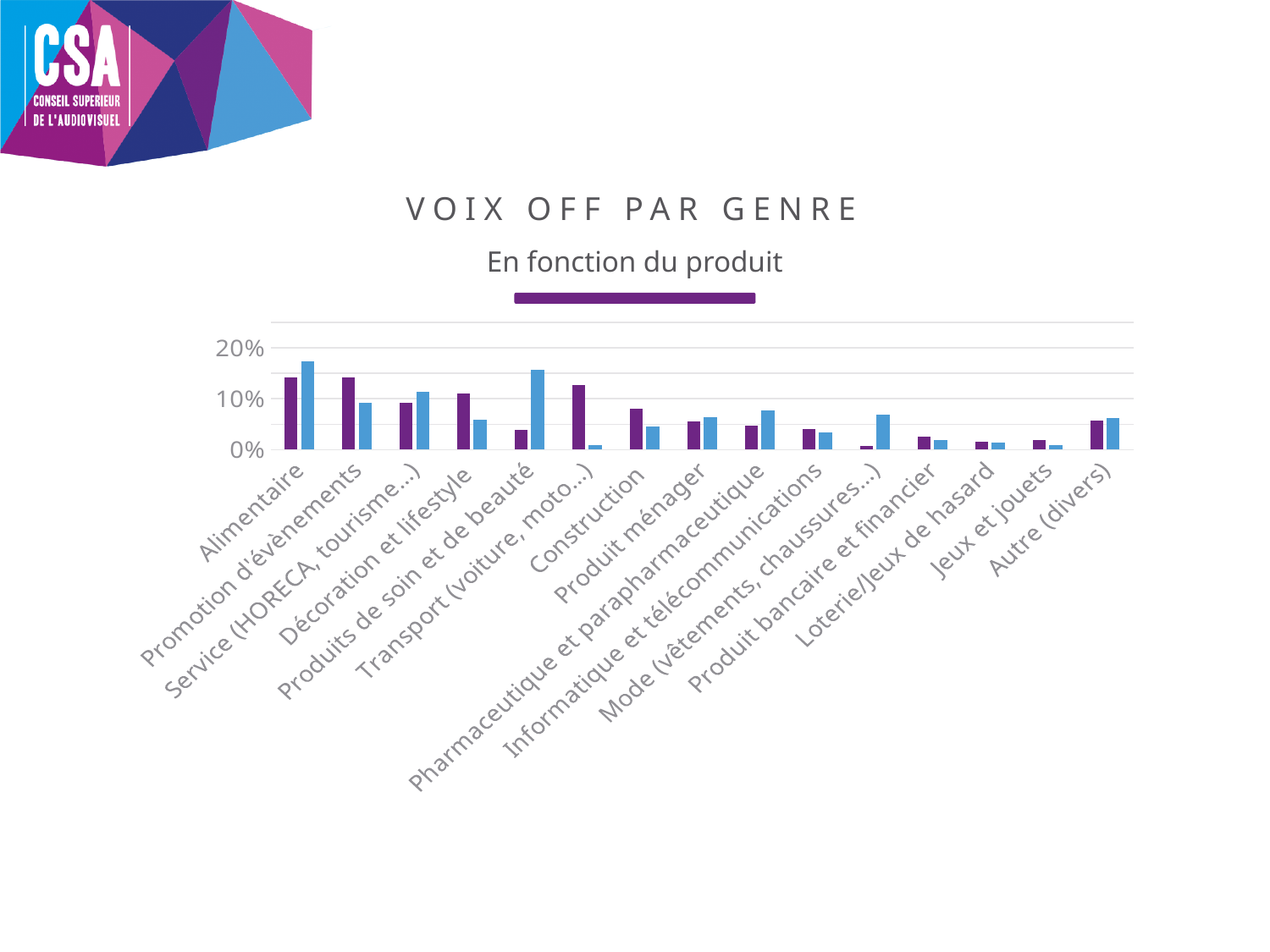
Is the purple bar for Promotion d'évènements greater or less than 10%? greater For Produits de soin et de beauté, which bar is taller, the purple one or the blue one? blue What is the title of the chart? VOIX OFF PAR GENRE What kind of chart is shown on the slide? bar chart What is the subtitle shown under the chart title? En fonction du produit Is the blue bar for Transport (voiture, moto...) greater or less than 10%? less For Mode (vêtements, chaussures...), which bar is taller, the purple one or the blue one? blue Is the purple bar for Produits de soin et de beauté greater or less than 10%? less For Transport (voiture, moto...), which bar is taller, the purple one or the blue one? purple Which category has the tallest blue bar? Alimentaire How many product categories are shown on the x axis of the chart? 15